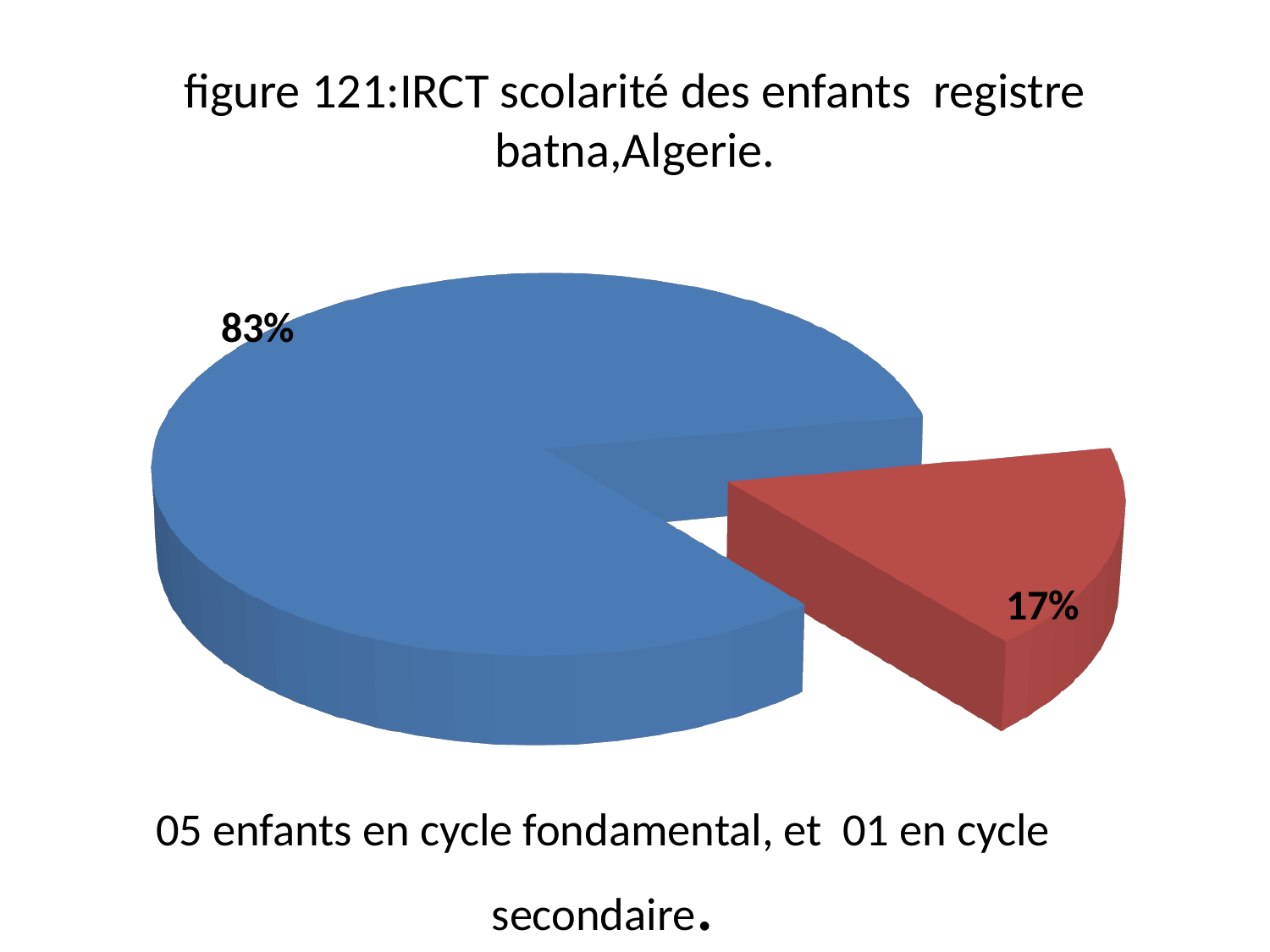
Which is larger, the blue slice or the red slice? the blue slice How many slices does the pie chart have? 2 What share of the pie does the red slice represent? 17% Which slice of the pie chart is the smallest? the red slice (17%) What is the difference in percentage points between the blue slice and the red slice? 66 percentage points What do the two slice percentages add up to? 100% What colour is the slice that is pulled out from the rest of the pie? red Which slice of the pie chart is the largest? the blue slice (83%) What kind of chart is shown on the slide? pie chart What percentage is shown on the red slice of the pie chart? 17% What percentage is shown on the blue slice of the pie chart? 83% What is the title of the chart? figure 121:IRCT scolarité des enfants registre batna,Algerie.